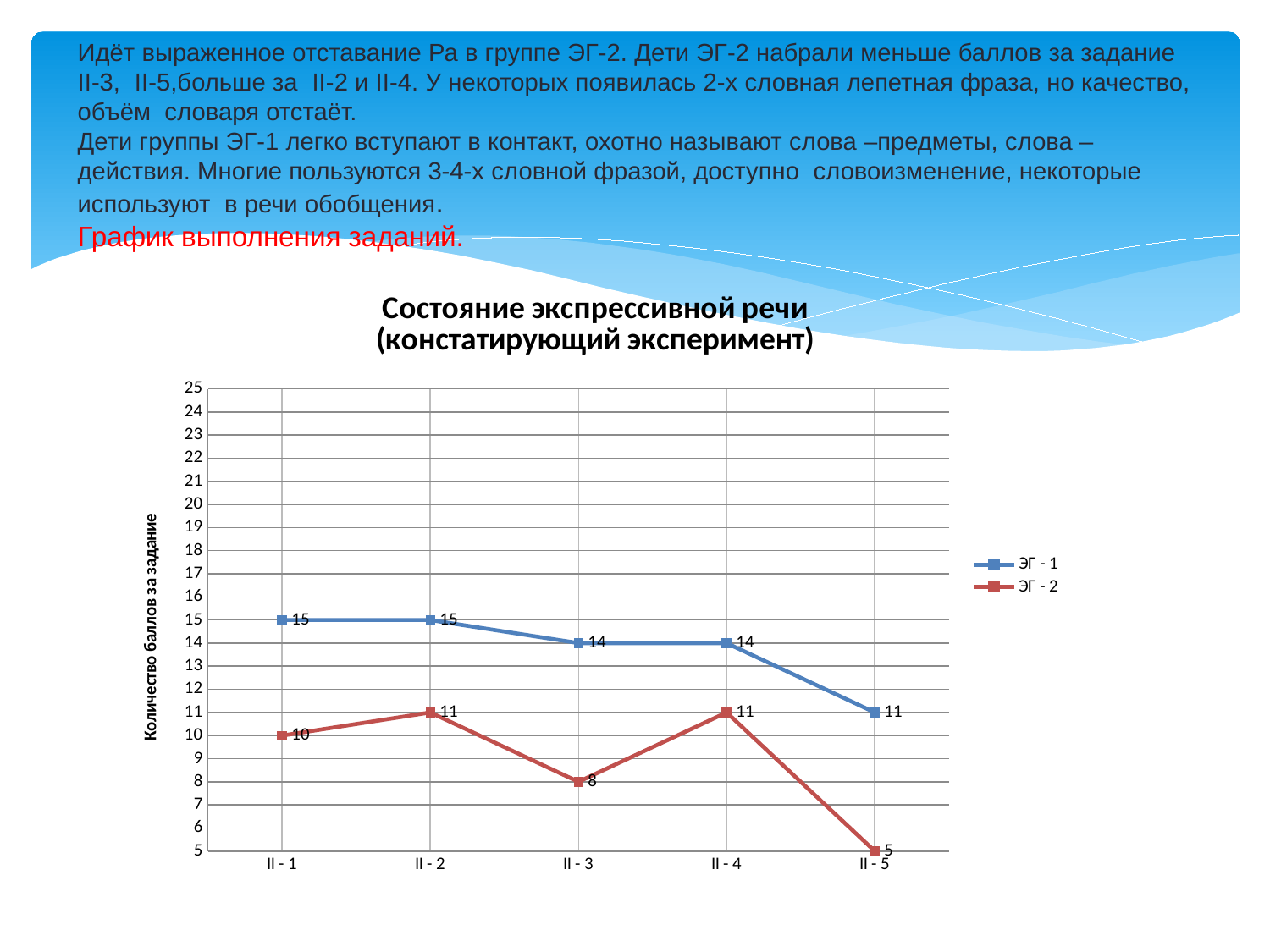
What is the difference between ЭГ - 1 and ЭГ - 2 at II - 3? 6 What is the title of the chart? Состояние экспрессивной речи (констатирующий эксперимент) What is the value for ЭГ - 1 at II - 3? 14 At which task does ЭГ - 2 have its lowest value? II - 5 What is the value for ЭГ - 2 at II - 5? 5 Does the ЭГ - 1 series rise or fall from II - 1 to II - 5? fall What is the value for ЭГ - 2 at II - 1? 10 How many series does the legend list? 2 At which task does ЭГ - 2 have its highest value? II - 2 and II - 4 How many tasks are shown on the x axis? 5 What type of chart is shown on the slide? line chart Which series has the larger value at II - 4, ЭГ - 1 or ЭГ - 2? ЭГ - 1